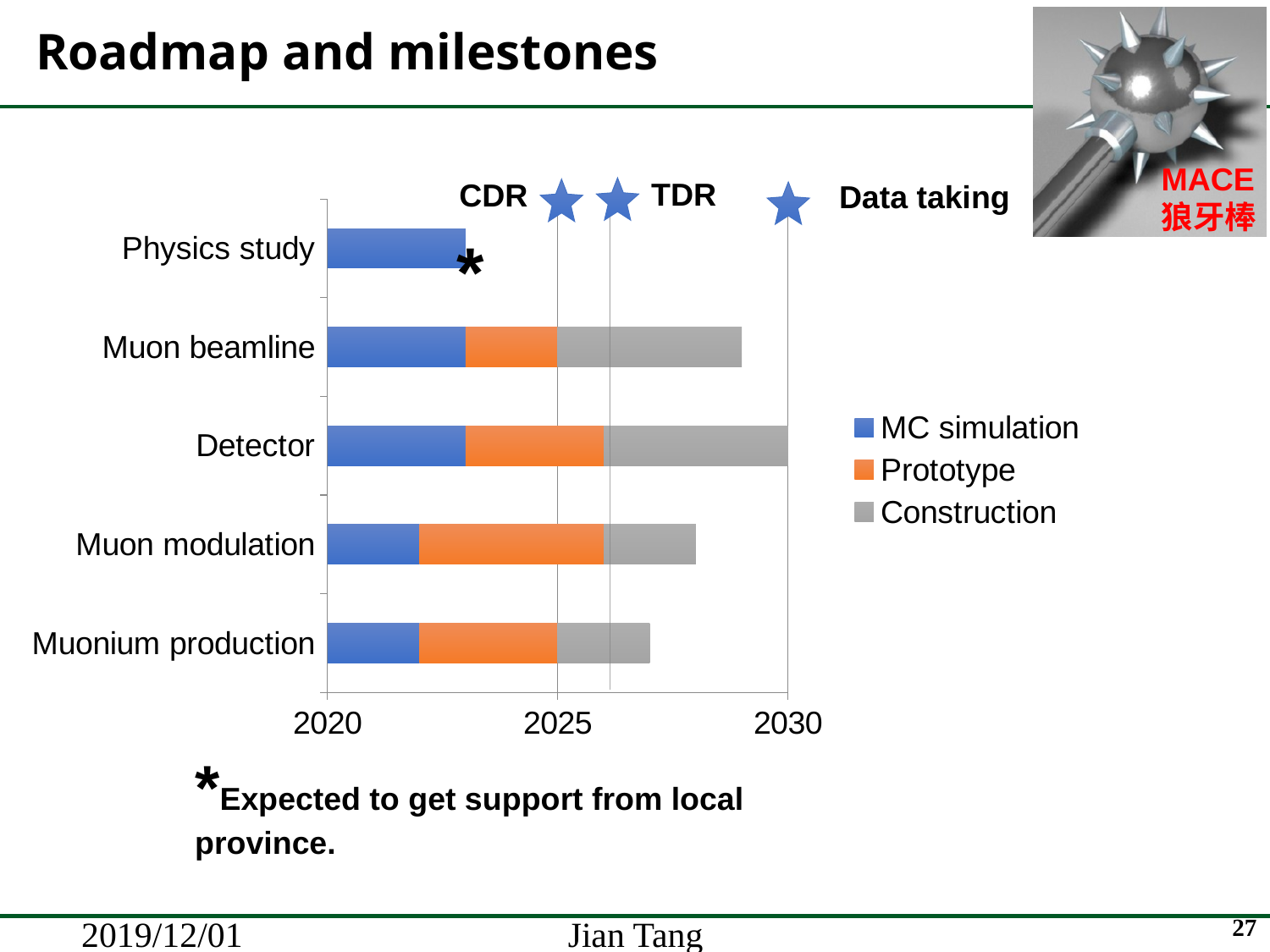
Which bar extends further along the time axis, Muon beamline or Muonium production? Muon beamline What kind of chart is shown on the slide? Stacked bar chart Which category has the shortest bar? Physics study Which category's bar extends furthest along the time axis? Detector Which bar extends further along the time axis, Detector or Muon modulation? Detector How many categories are listed on the vertical axis of the chart? 5 Does the Muonium production bar end before or after 2025? after How many series does the chart legend list? 3 Which series is shown in grey in the legend? Construction Which series is shown in orange in the legend? Prototype Does the Physics study bar end before or after 2025? before Does the Muon beamline bar end before or after 2030? before